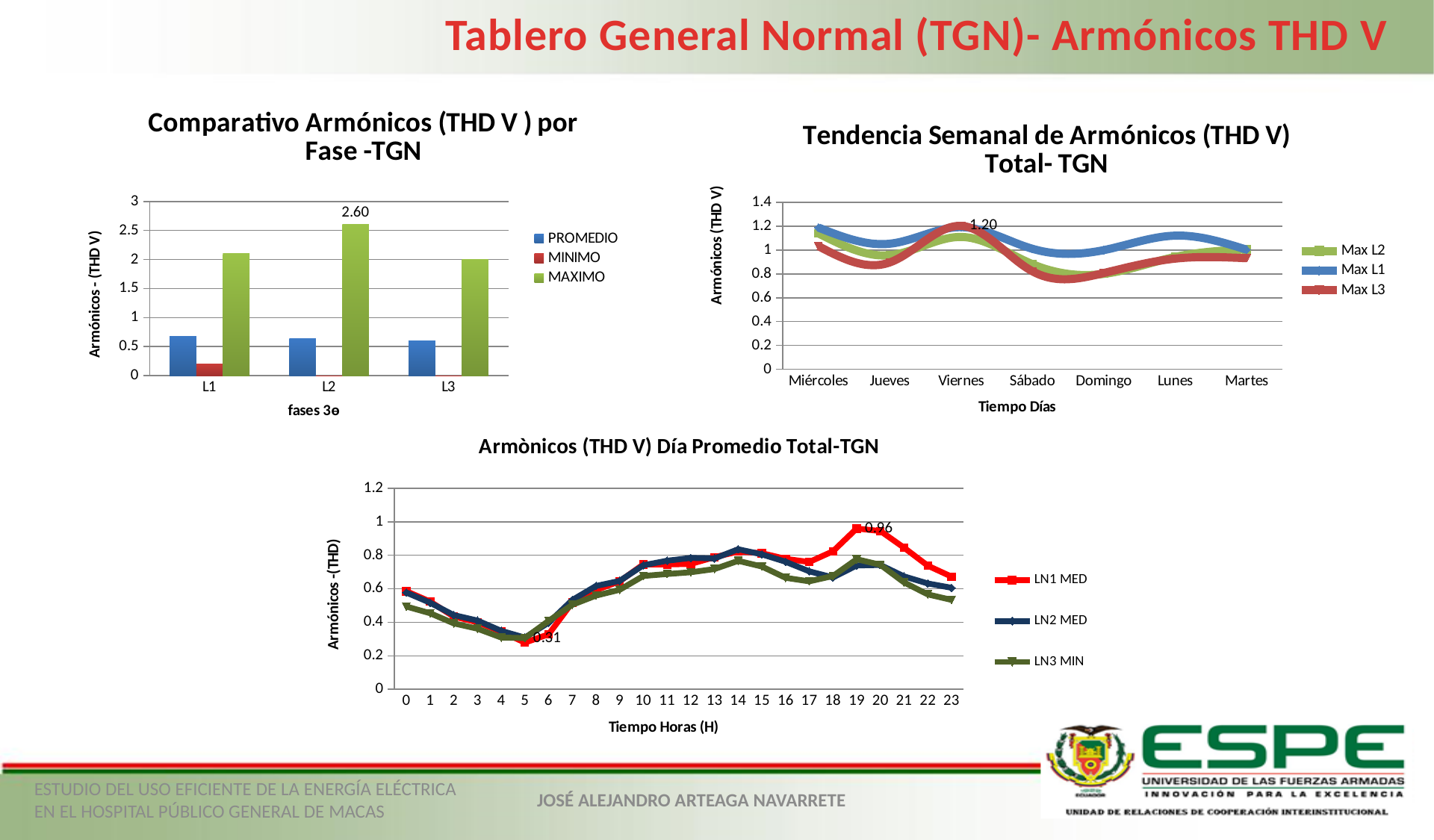
In the chart 'Comparativo Armónicos (THD V ) por Fase -TGN', what is the MAXIMO value for L2? 2.60 In the chart 'Comparativo Armónicos (THD V ) por Fase -TGN', what kind of chart is it? bar chart In the chart 'Tendencia Semanal de Armónicos (THD V) Total- TGN', is the Max L3 value for Domingo greater or less than 1? less In the chart 'Tendencia Semanal de Armónicos (THD V) Total- TGN', which series are listed in the legend? Max L2, Max L1, Max L3 In the chart 'Armònicos (THD V) Día Promedio Total-TGN', how many hours are shown on the x axis? 24 In the chart 'Tendencia Semanal de Armónicos (THD V) Total- TGN', how many days are shown on the x axis? 7 In the chart 'Armònicos (THD V) Día Promedio Total-TGN', at which hour does LN1 MED reach its highest value? 19 In the chart 'Tendencia Semanal de Armónicos (THD V) Total- TGN', what value is labelled at Viernes? 1.20 In the chart 'Comparativo Armónicos (THD V ) por Fase -TGN', which phase has the highest MAXIMO value? L2 In the chart 'Comparativo Armónicos (THD V ) por Fase -TGN', how many series does the legend list? 3 In the chart 'Armònicos (THD V) Día Promedio Total-TGN', what is the LN1 MED value at hour 19? 0.96 In the chart 'Comparativo Armónicos (THD V ) por Fase -TGN', is the PROMEDIO value for L1 greater or less than 1? less